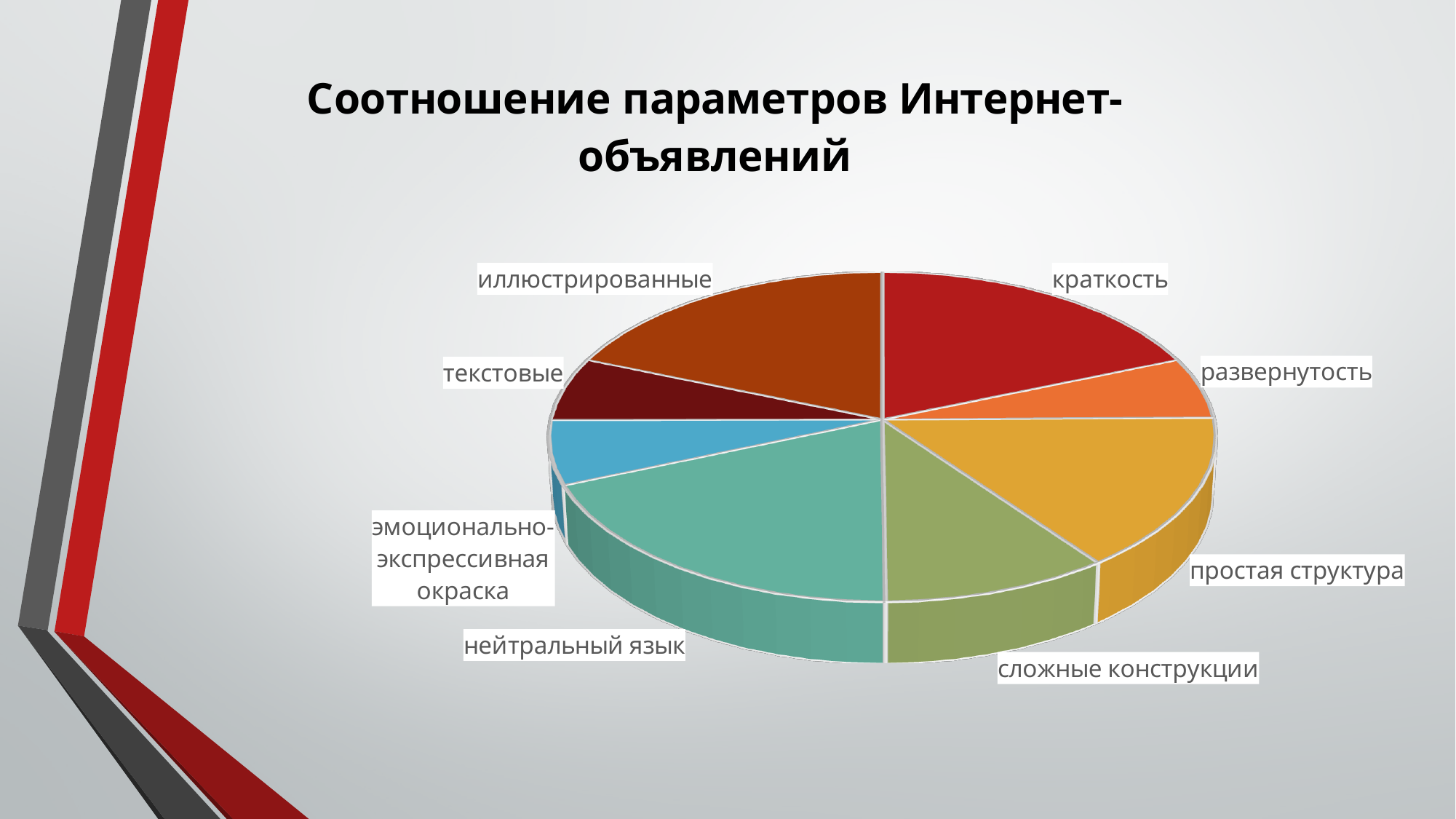
Which slice is larger: сложные конструкции or текстовые? сложные конструкции What kind of chart is shown on the slide? Pie chart What colour is the slice labelled краткость? Red Which slice is larger: иллюстрированные or текстовые? иллюстрированные Which slice is larger: нейтральный язык or развернутость? нейтральный язык What is the title of the chart on the slide? Соотношение параметров Интернет-объявлений How many slices does the pie chart have? 8